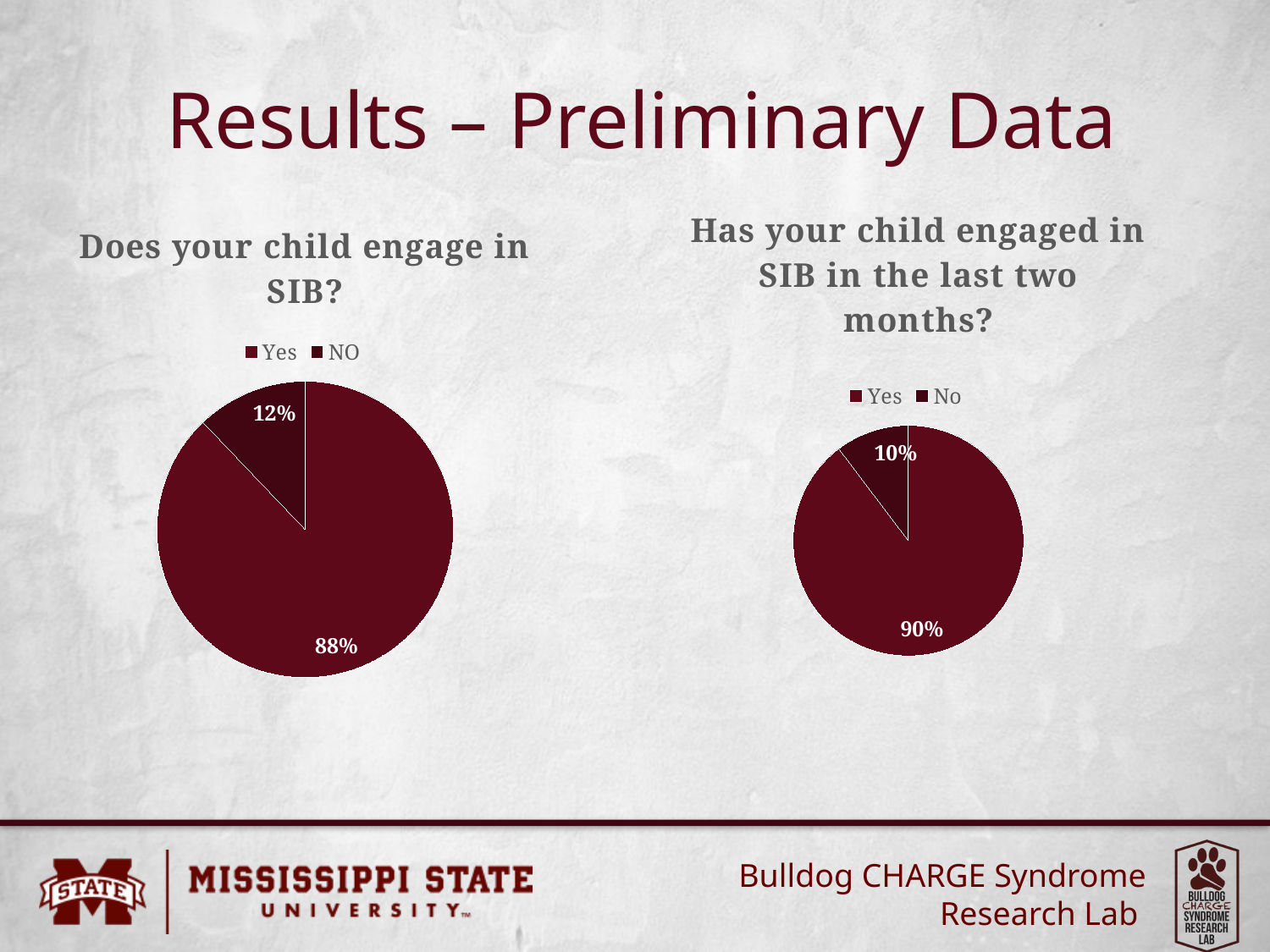
What type of chart is used on the left side of the slide? Pie chart How many categories does the legend of the chart on the right list? 2 In the chart titled "Has your child engaged in SIB in the last two months?", what percentage of responses are No? 10% In the chart titled "Does your child engage in SIB?", what is the difference between the Yes and NO percentages? 76% In the chart titled "Does your child engage in SIB?", what percentage of responses are Yes? 88% Is the Yes share larger in the left chart or the right chart? The right chart In the chart titled "Has your child engaged in SIB in the last two months?", what is the difference between the Yes and No percentages? 80% In the chart titled "Does your child engage in SIB?", what percentage of responses are NO? 12% In the chart on the right, which category has the smallest slice? No What is the title of the chart on the right? Has your child engaged in SIB in the last two months? In the chart on the left, which category has the largest slice? Yes In the chart titled "Has your child engaged in SIB in the last two months?", what percentage of responses are Yes? 90%